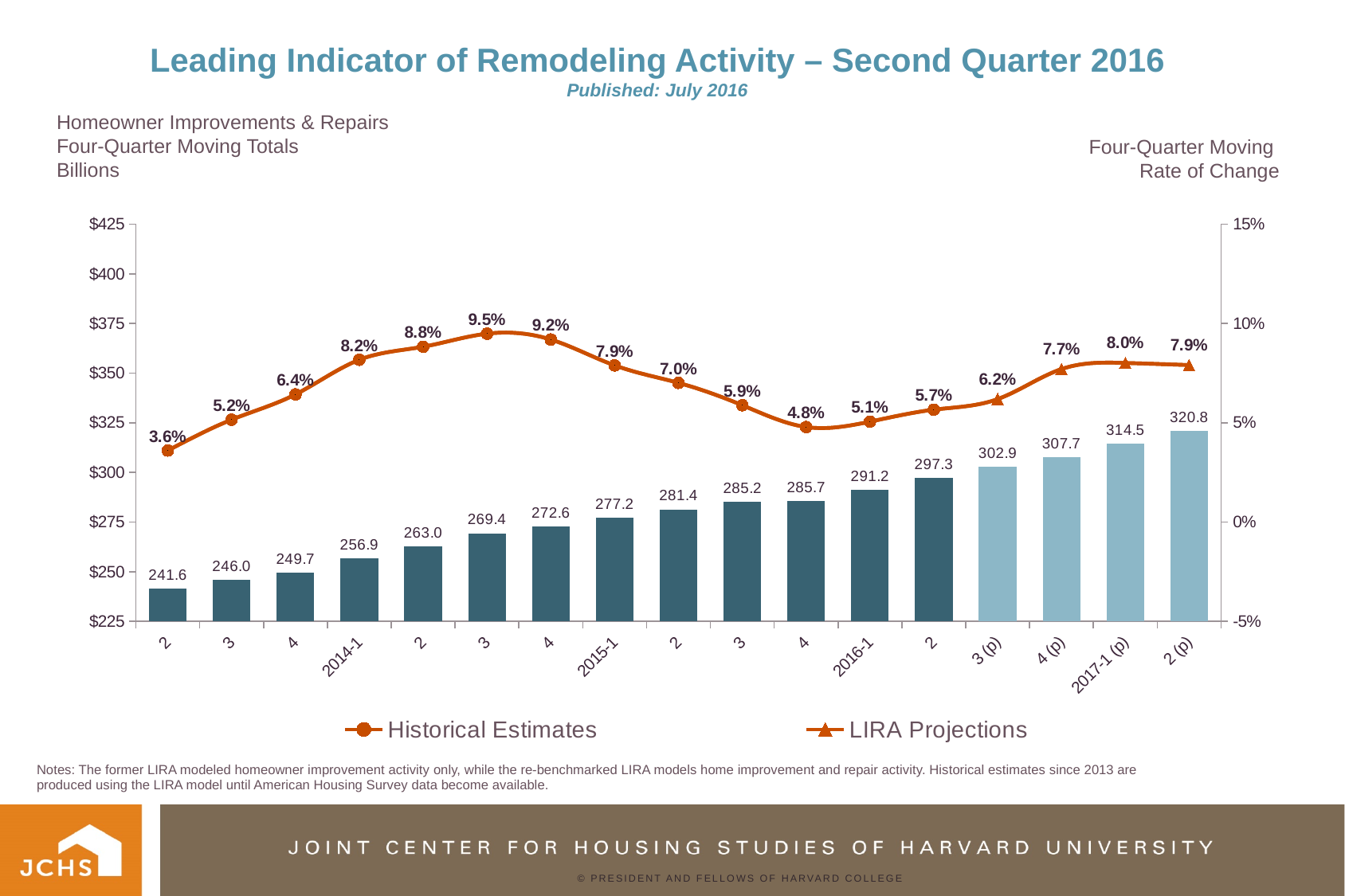
What are the two entries listed in the chart legend? Historical Estimates and LIRA Projections How many series does the legend list? 2 What is the projected four-quarter moving total for 2017-1 (p)? 314.5 What is the highest four-quarter moving rate of change shown on the line? 9.5% How many bars are plotted on the chart? 17 Do the four-quarter moving totals (bars) rise or fall from left to right along the x axis? Rise What is the four-quarter moving total (in billions) for 2014-1? 256.9 What kind of chart is shown on the slide? Combination bar and line chart What is the lowest four-quarter moving rate of change shown on the line? 3.6% What is the four-quarter moving rate of change for 2015-1? 7.9% What is the difference between the four-quarter moving total for 2 (p) (320.8) and for 2016 quarter 2 (297.3)? 23.5 Which has a larger four-quarter moving total, 2015-1 or 2016-1? 2016-1